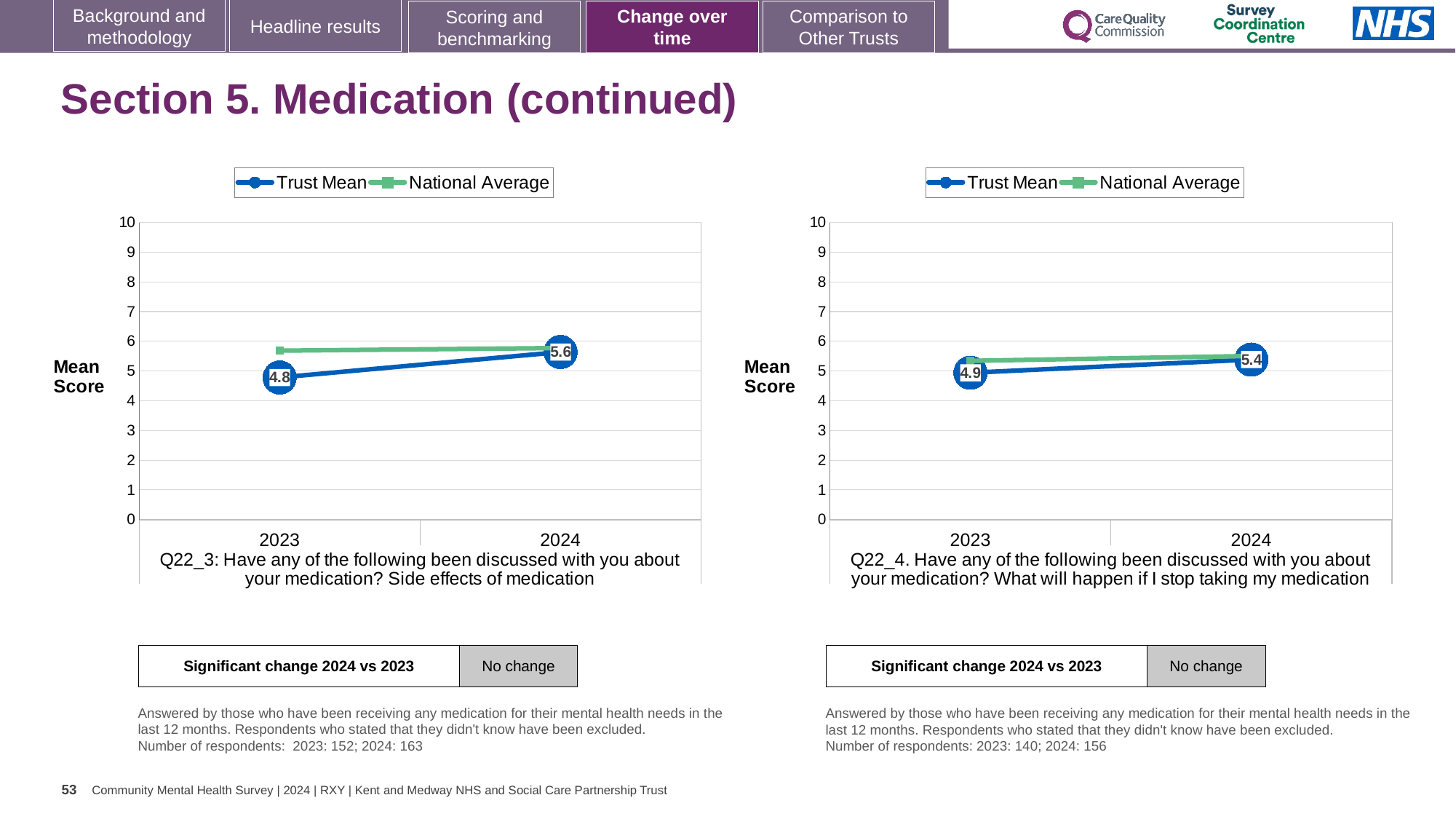
In the Q22_3 chart on the left, is the National Average for 2023 greater or less than 5? greater In the Q22_3 chart on the left, does the Trust Mean rise or fall from 2023 to 2024? rise In the Q22_3 chart on the left, what is the Trust Mean for 2024? 5.6 In the Q22_3 chart on the left, what is the Trust Mean for 2023? 4.8 In the Q22_4 chart on the right, does the Trust Mean rise or fall from 2023 to 2024? rise In the Q22_4 chart on the right, what is the difference between the Trust Mean for 2024 and 2023? 0.5 How many series does the legend of the Q22_4 chart on the right list? 2 In the Q22_4 chart on the right, what is the Trust Mean for 2023? 4.9 In the Q22_4 chart on the right, what is the Trust Mean for 2024? 5.4 In the Q22_3 chart on the left, by how much did the Trust Mean change from 2023 to 2024? 0.8 In the Q22_3 chart on the left, which is larger for 2023, the Trust Mean or the National Average? National Average What type of chart is the Q22_3 chart on the left? line chart